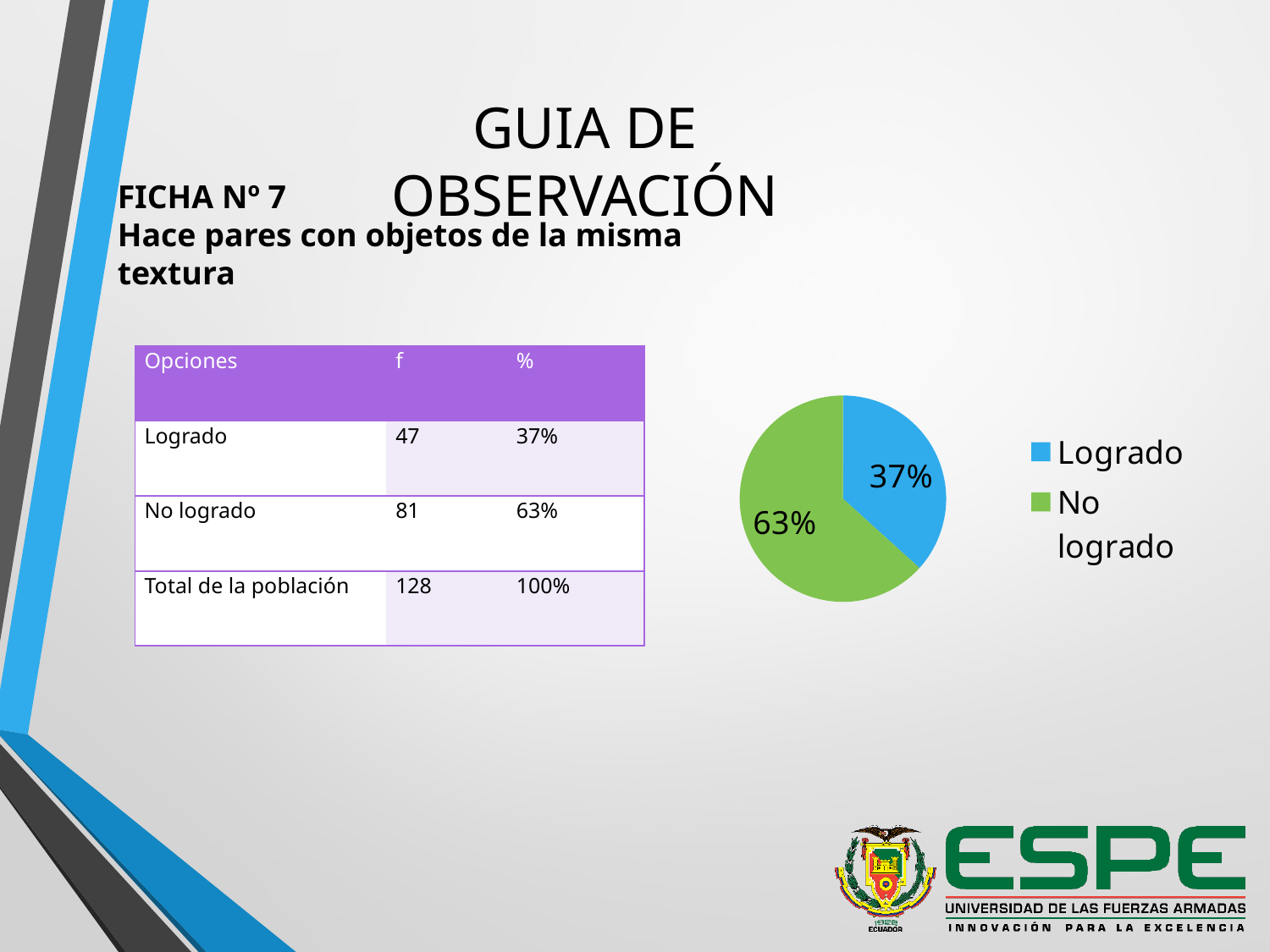
What is the difference in percentage points between the No logrado and Logrado slices? 26% What percentage does the pie chart show for No logrado? 63% What colour is the No logrado slice in the pie chart? green How many entries does the pie chart legend list? 2 How many slices does the pie chart have? 2 Which slice of the pie chart is the largest? No logrado What share of the pie does the Logrado slice represent? 37% Which slice of the pie chart is the smallest? Logrado What kind of chart is shown on the slide? pie chart What colour is the Logrado slice in the pie chart? blue Which is larger in the pie chart, Logrado or No logrado? No logrado What percentage does the pie chart show for Logrado? 37%